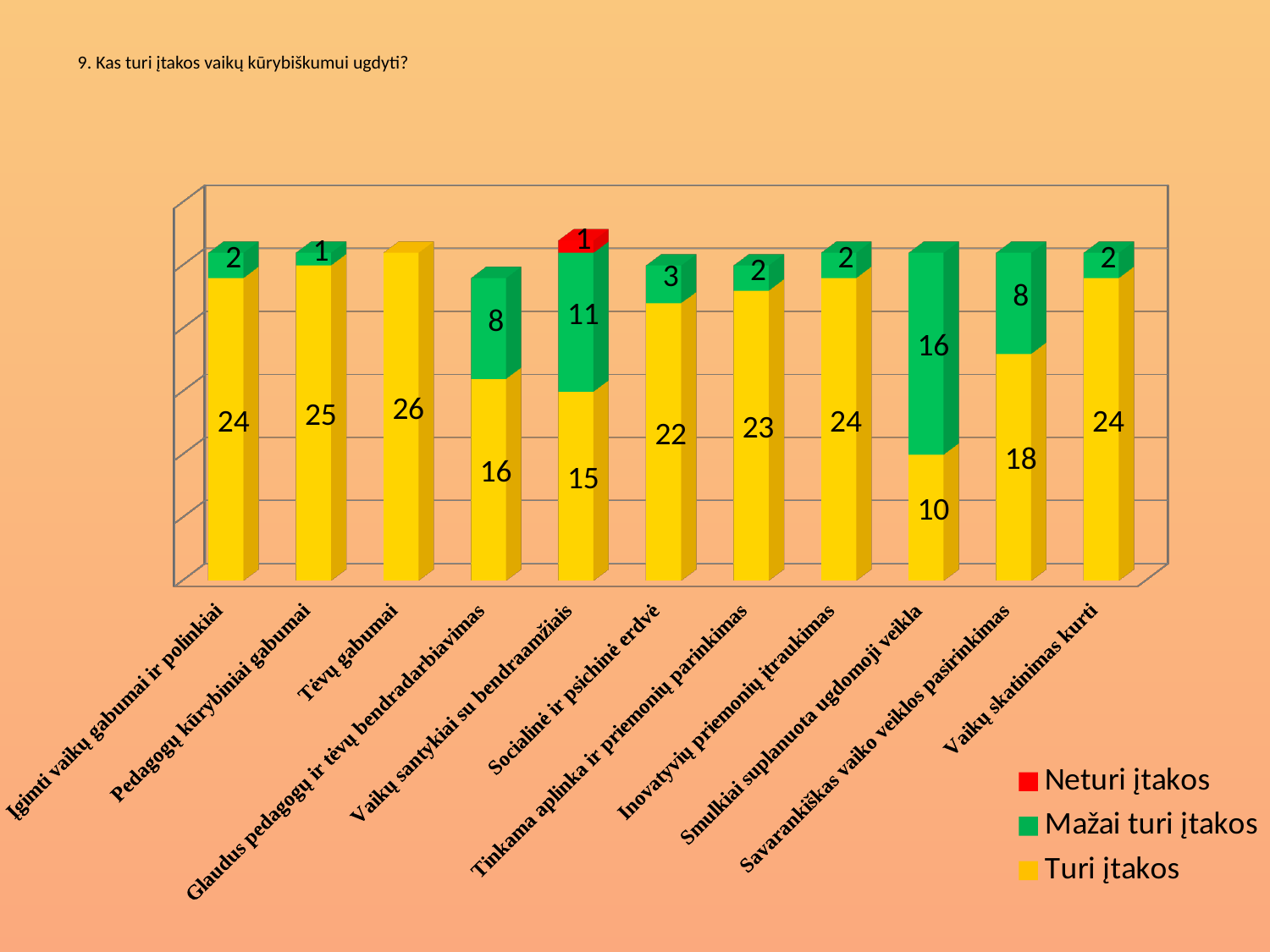
What is the 'Neturi įtakos' value for 'Vaikų santykiai su bendraamžiais'? 1 Which category has the lowest 'Turi įtakos' value? Smulkiai suplanuota ugdomoji veikla What is the 'Mažai turi įtakos' value for 'Smulkiai suplanuota ugdomoji veikla'? 16 How many categories are shown on the x axis? 11 How many series does the legend list? 3 What is the difference between the 'Turi įtakos' values for 'Pedagogų kūrybiniai gabumai' and 'Glaudus pedagogų ir tėvų bendradarbiavimas'? 9 What is the total of the stacked bar for 'Vaikų santykiai su bendraamžiais'? 27 Which has a larger 'Mažai turi įtakos' value: 'Vaikų santykiai su bendraamžiais' or 'Socialinė ir psichinė erdvė'? Vaikų santykiai su bendraamžiais Which category has the highest 'Turi įtakos' value? Tėvų gabumai What kind of chart is shown on the slide? Stacked bar chart What is the 'Turi įtakos' value for 'Tėvų gabumai'? 26 What is the 'Turi įtakos' value for 'Savarankiškas vaiko veiklos pasirinkimas'? 18